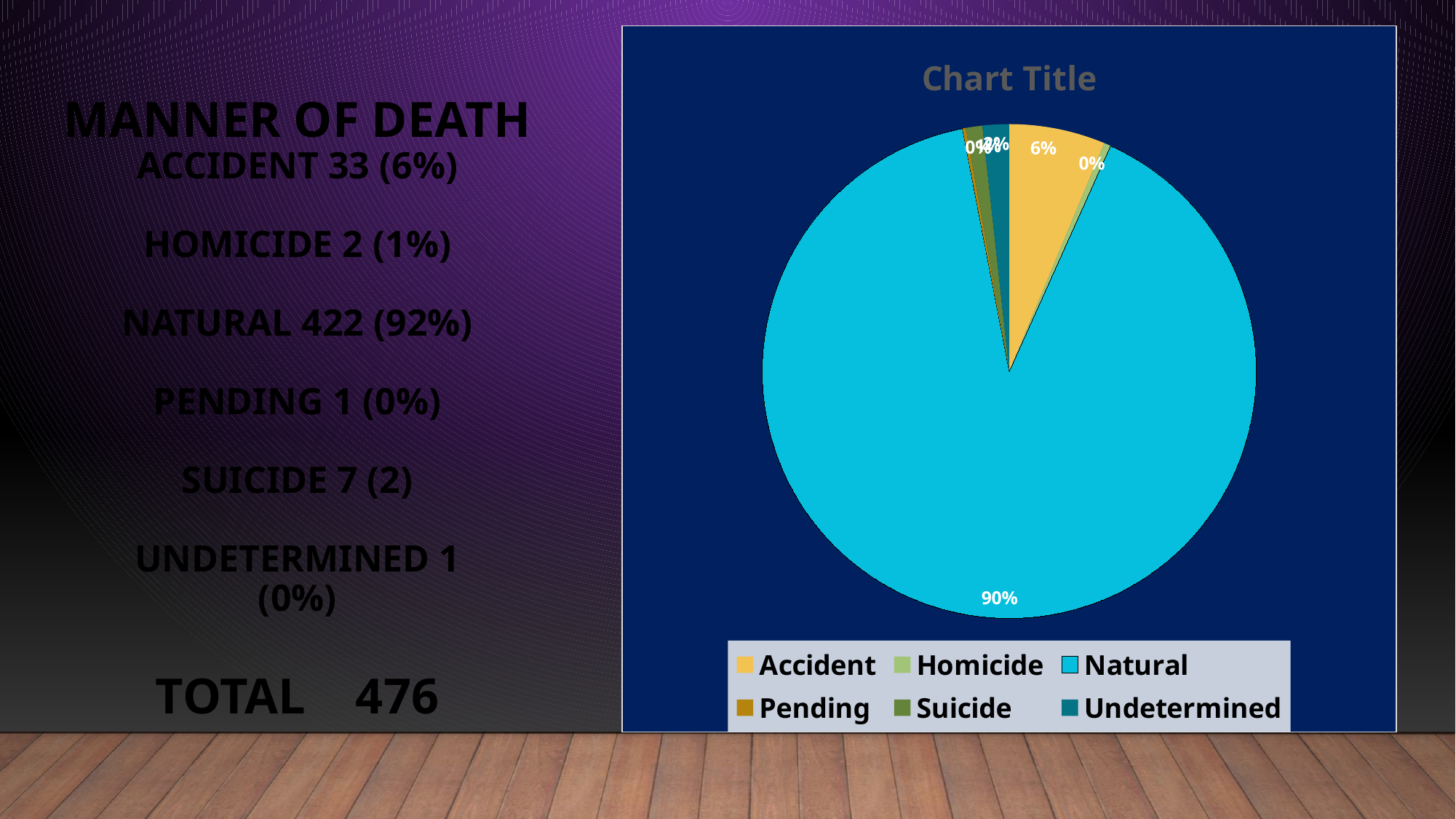
How many categories does the pie chart's legend list? 6 What is the title shown above the pie chart? Chart Title Which slice is larger, Natural or Accident? Natural What percentage of the pie is labelled for Accident? 6% What percentage of the pie is labelled for Homicide? 0% What kind of chart is shown on the slide? pie chart What percentage of the pie is labelled for Natural? 90% Which slice is larger, Accident or Homicide? Accident Which category has the largest slice of the pie? Natural Which category is shown in yellow in the pie chart's legend? Accident